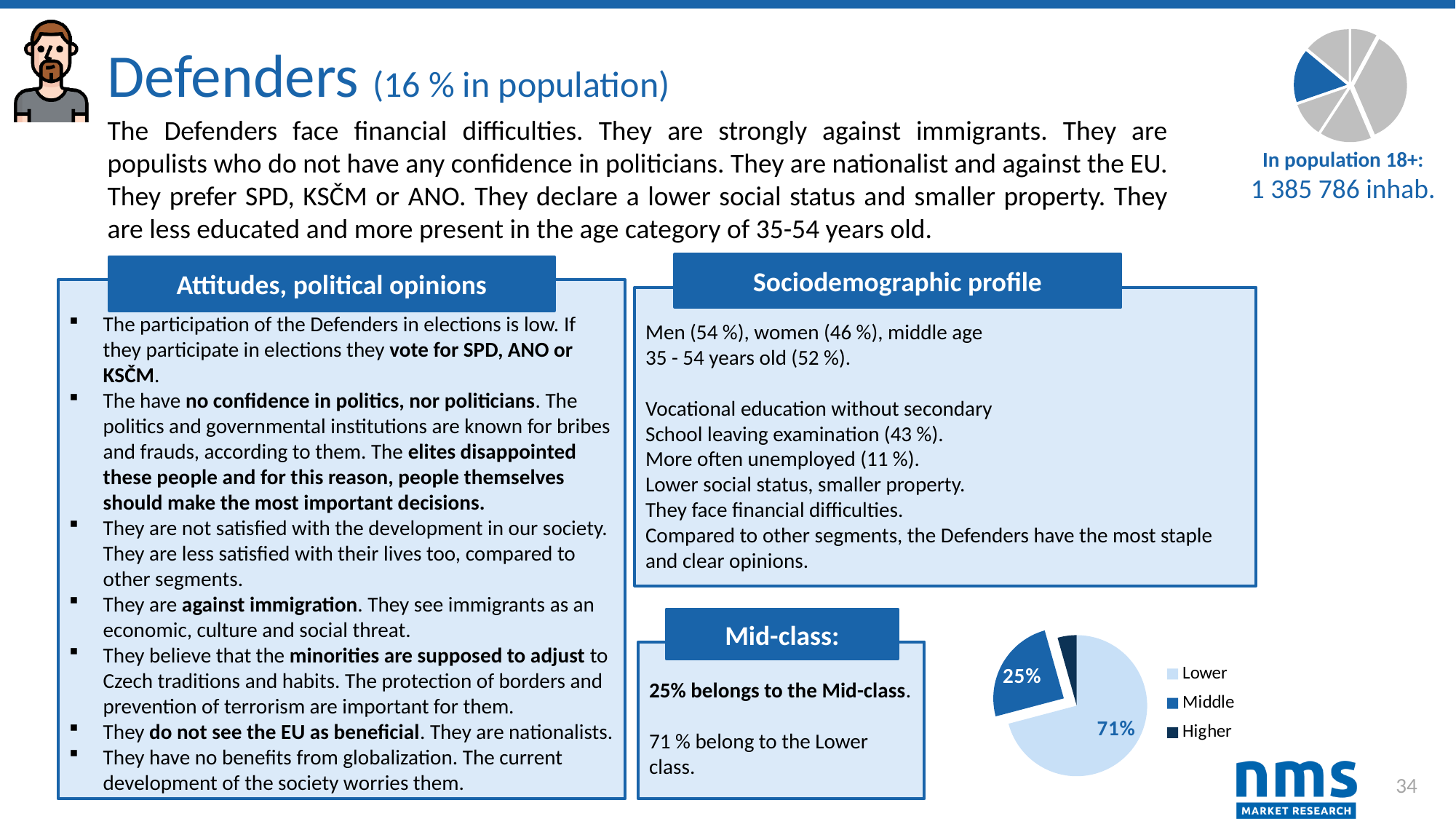
In the pie chart at the bottom right of the slide, what share is shown for the Middle class? 25% What are the legend entries of the pie chart at the bottom right of the slide? Lower, Middle, Higher What type of chart is shown at the bottom right of the slide next to the Mid-class box? Pie chart In the pie chart at the bottom right of the slide, what share is shown for the Lower class? 71% In the pie chart at the bottom right of the slide, which slice is larger, Lower or Middle? Lower How many categories does the legend of the pie chart at the bottom right of the slide list? 3 In the pie chart at the bottom right of the slide, what is the difference in percentage points between the Lower and Middle slices? 46% In the pie chart at the bottom right of the slide, which category has the largest slice? Lower In the pie chart at the bottom right of the slide, which slice is shown in the lightest blue colour? Lower In the pie chart at the bottom right of the slide, which category has the smallest slice? Higher